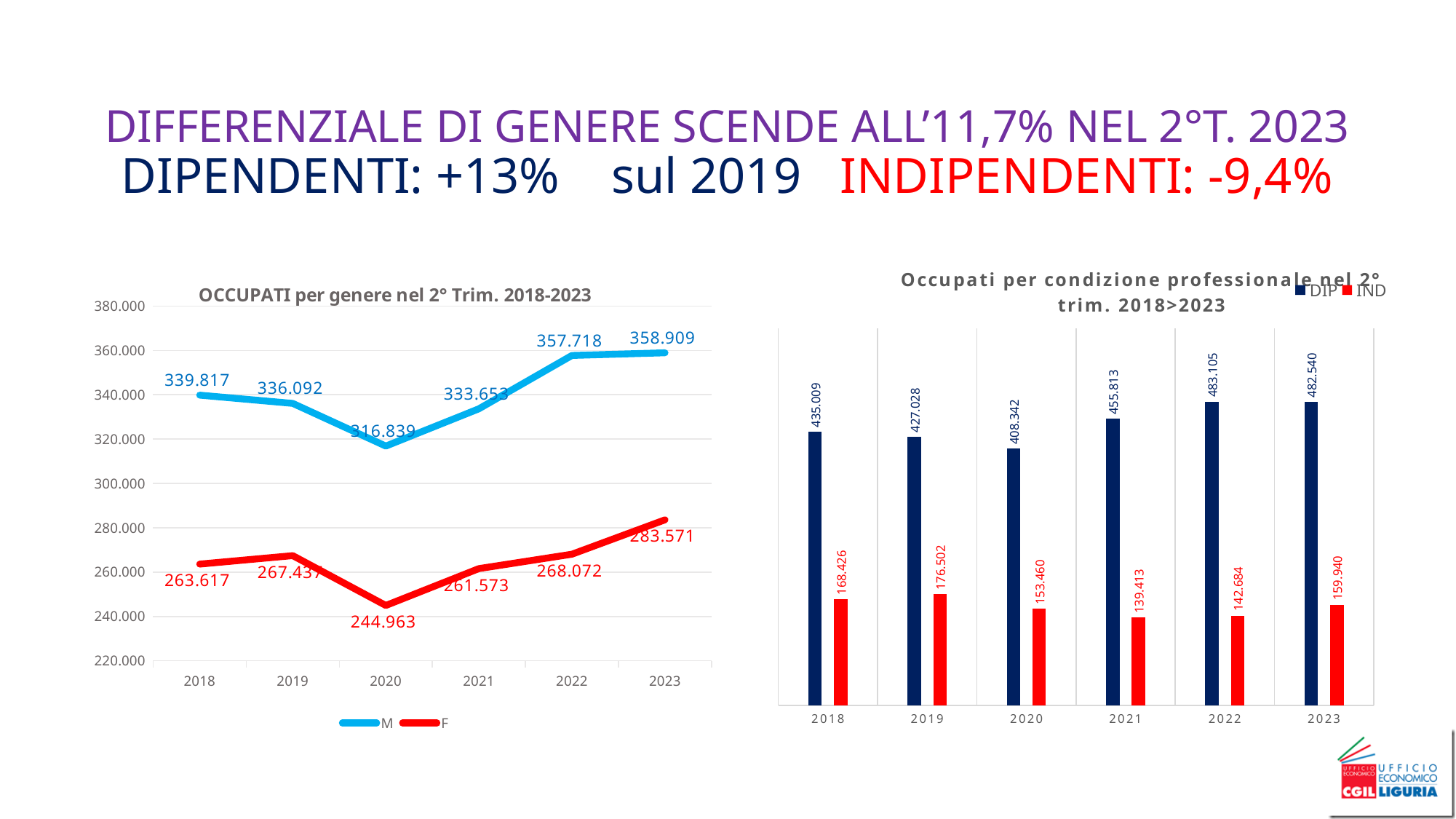
In the left chart 'OCCUPATI per genere nel 2° Trim. 2018-2023', what is the value for F in 2023? 283.571 In the right chart 'Occupati per condizione professionale nel 2° trim. 2018>2023', how many years are shown on the x axis? 6 In the left chart 'OCCUPATI per genere nel 2° Trim. 2018-2023', how many series does the legend list? 2 In the right chart 'Occupati per condizione professionale nel 2° trim. 2018>2023', what is the difference between IND in 2019 and IND in 2021? 37.089 In the right chart 'Occupati per condizione professionale nel 2° trim. 2018>2023', what is the value for IND in 2020? 153.460 In the left chart 'OCCUPATI per genere nel 2° Trim. 2018-2023', what is the difference between M and F in 2023? 75.338 In the right chart 'Occupati per condizione professionale nel 2° trim. 2018>2023', which year has the lowest value for IND? 2021 In the left chart 'OCCUPATI per genere nel 2° Trim. 2018-2023', what type of chart is shown? Line chart In the left chart 'OCCUPATI per genere nel 2° Trim. 2018-2023', which year has the lowest value for F? 2020 In the right chart 'Occupati per condizione professionale nel 2° trim. 2018>2023', what is the value for DIP in 2021? 455.813 In the right chart 'Occupati per condizione professionale nel 2° trim. 2018>2023', which year has the highest value for DIP? 2022 In the left chart 'OCCUPATI per genere nel 2° Trim. 2018-2023', what is the value for M in 2020? 316.839